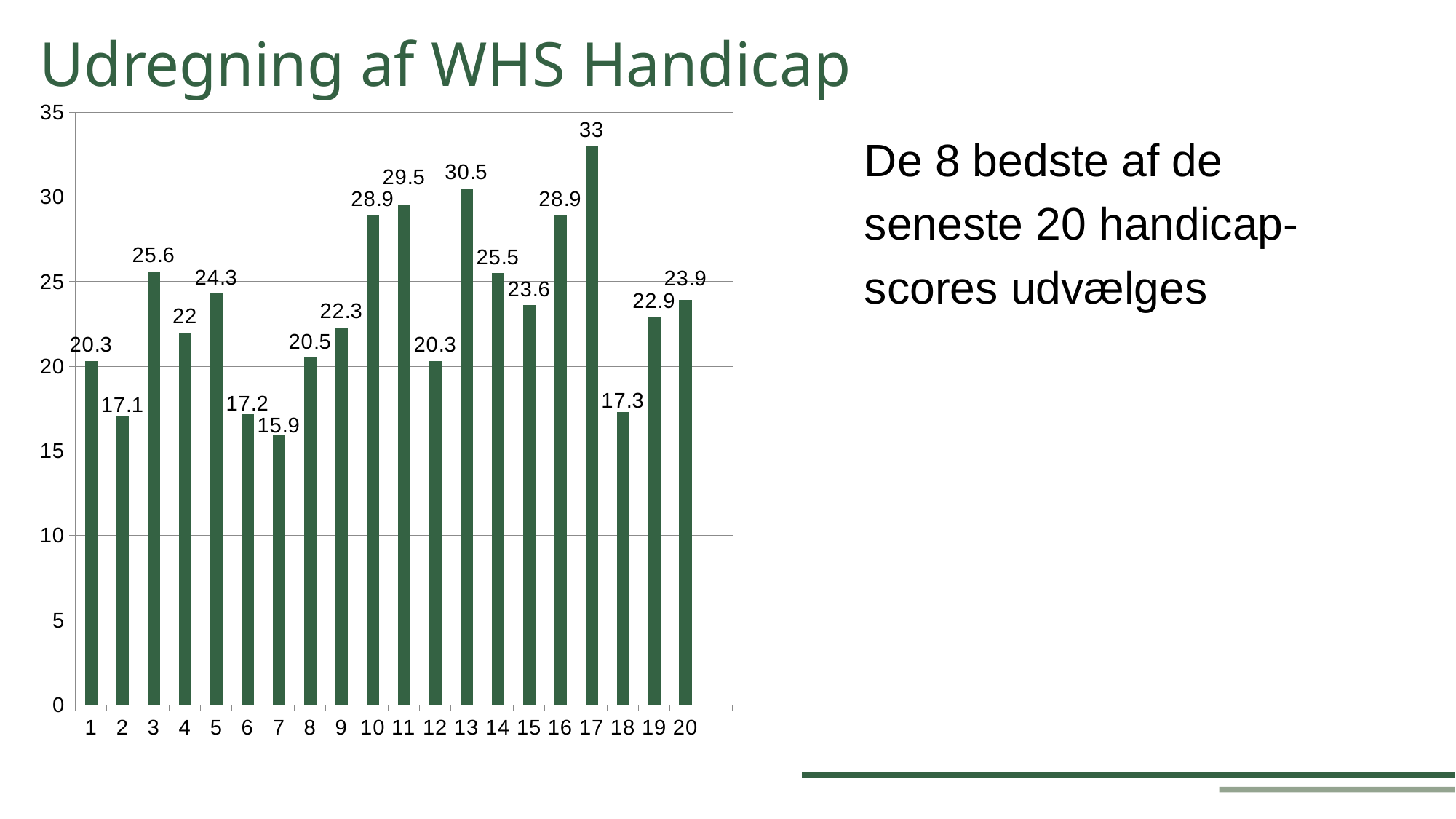
Is the value for category 11 greater or less than 25? greater What kind of chart is shown on the slide? Bar chart How many categories are shown on the x axis? 20 Which category has the highest value? 17 What is the value for category 17? 33 What is the difference between the values for category 17 and category 7? 17.1 What is the value for category 13? 30.5 What is the difference between the values for category 10 and category 16? 0 Which category has the lowest value? 7 What is the title of the slide containing the chart? Udregning af WHS Handicap Which is larger, the value for category 3 or the value for category 5? Category 3 What is the value for category 7? 15.9